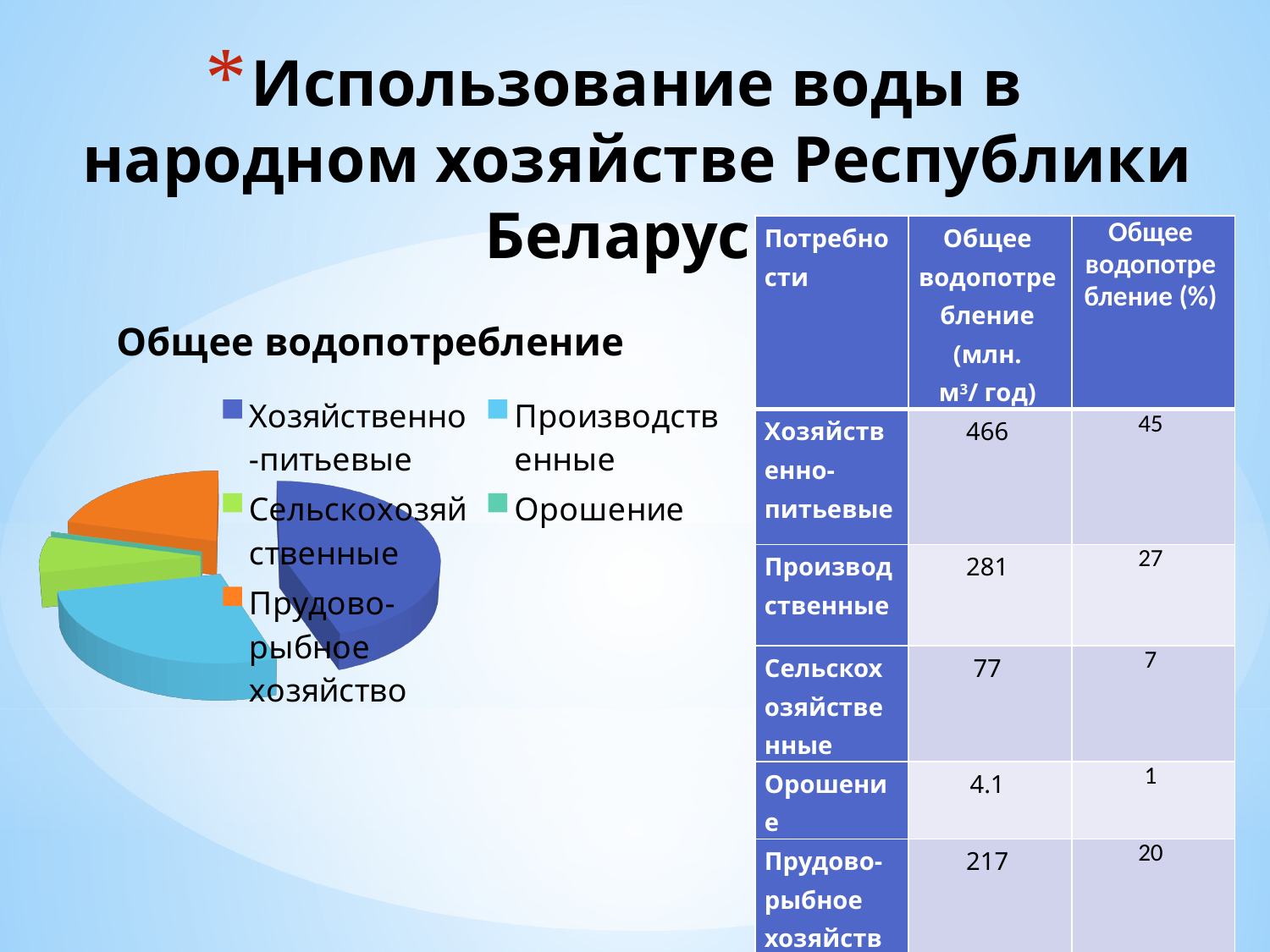
According to the table on the slide, what is the total water consumption (млн. м³/год) for Хозяйственно-питьевые? 466 Which category has the smallest slice in the pie chart? Орошение What is the title of the pie chart? Общее водопотребление According to the table on the slide, what share (%) of total water consumption is Производственные? 27 How many categories does the pie chart's legend list? 5 In the pie chart, which slice is larger: Хозяйственно-питьевые or Производственные? Хозяйственно-питьевые Which category has the largest slice in the pie chart? Хозяйственно-питьевые According to the table on the slide, what is the difference in water consumption (млн. м³/год) between Хозяйственно-питьевые and Прудово-рыбное хозяйство? 249 In the pie chart, which slice is larger: Прудово-рыбное хозяйство or Сельскохозяйственные? Прудово-рыбное хозяйство According to the table on the slide, what is the total water consumption (млн. м³/год) for Орошение? 4.1 What kind of chart is shown on the slide? pie chart What colour is the Хозяйственно-питьевые slice in the pie chart? dark blue